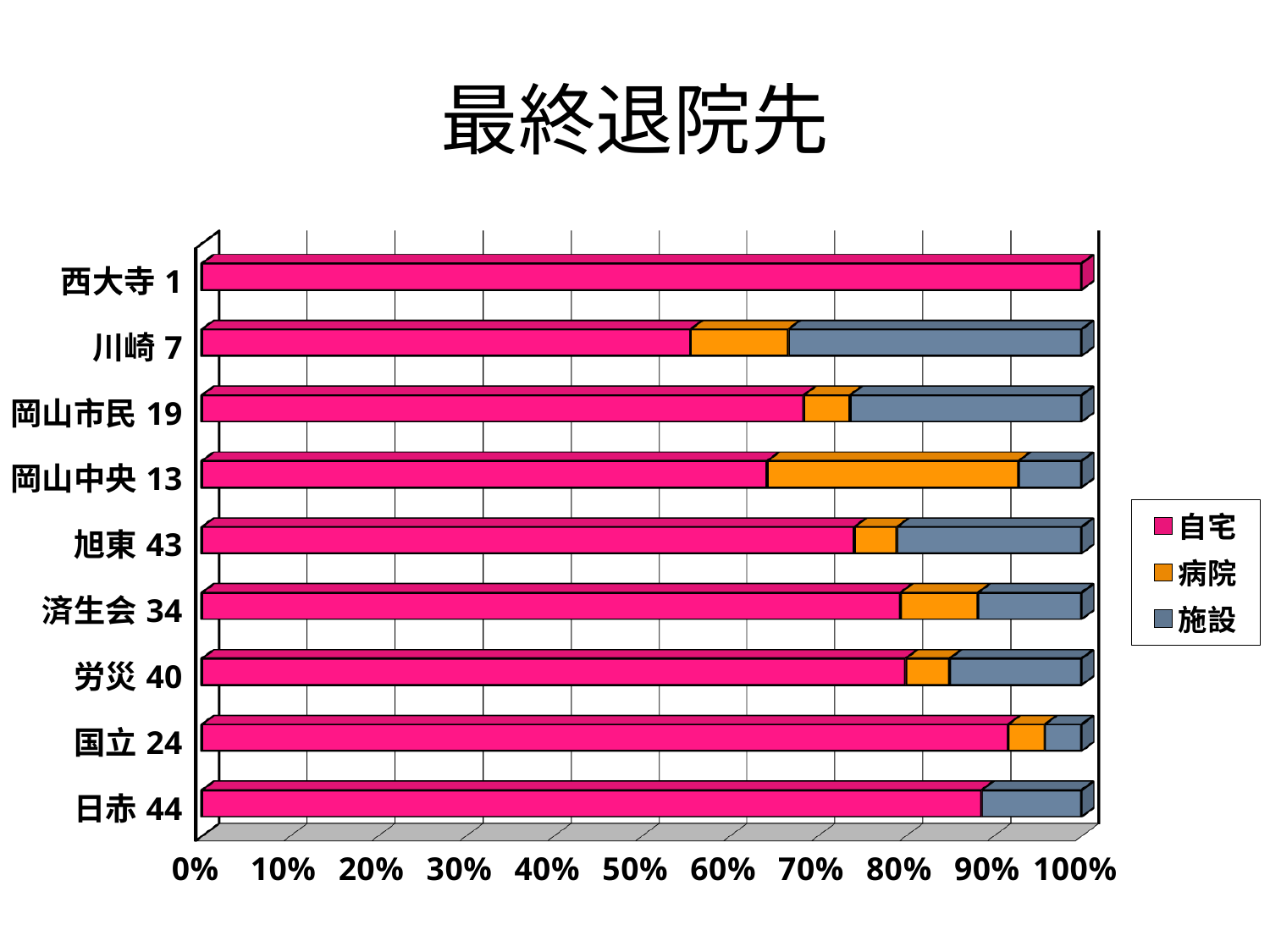
How many series does the legend list? 3 Which category has the highest share of 自宅? 西大寺 1 What is the title of the chart? 最終退院先 Which category has the largest 病院 segment? 岡山中央 13 Which legend entry is shown in pink? 自宅 Which has a larger 病院 share, 岡山中央 13 or 川崎 7? 岡山中央 13 What kind of chart is shown on the slide? Stacked bar chart Is the 自宅 share for 川崎 7 greater or less than 70%? less Is the 自宅 share for 日赤 44 greater or less than 80%? greater Is the 施設 share for 岡山中央 13 greater or less than 10%? less How many hospital categories are plotted on the chart? 9 Which category has the lowest share of 自宅? 川崎 7